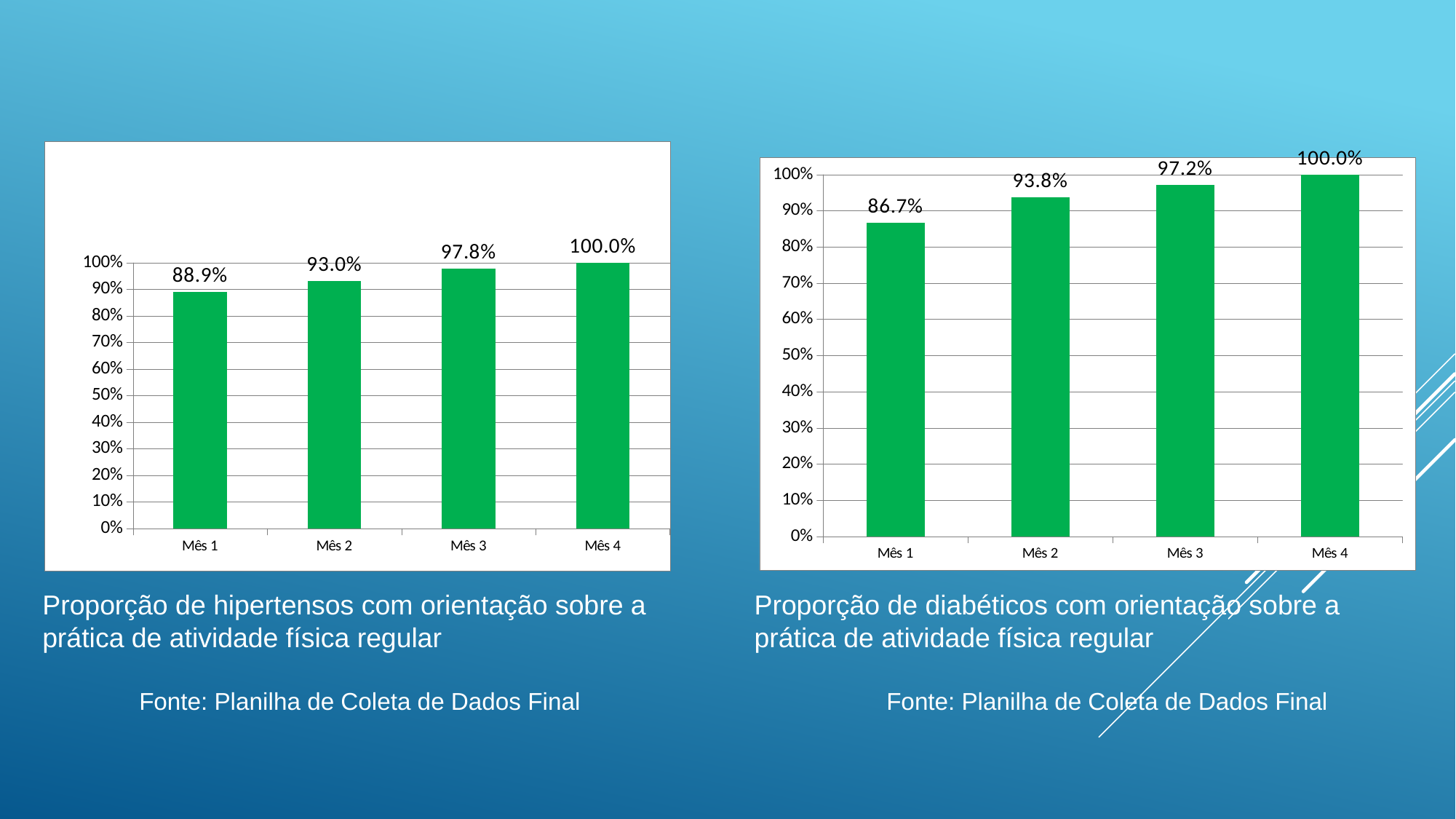
What type of chart is the left chart (hipertensos)? Bar chart In the right chart (diabéticos), what is the value for Mês 1? 86.7% In the left chart (hipertensos), what is the value for Mês 3? 97.8% In the left chart (hipertensos), what is the difference between the values for Mês 4 and Mês 1? 11.1% Which is larger: the Mês 1 value in the left chart (hipertensos) or the Mês 1 value in the right chart (diabéticos)? Left chart (hipertensos), 88.9% In the right chart (diabéticos), which month has the highest value? Mês 4 In the right chart (diabéticos), what is the difference between the values for Mês 3 and Mês 2? 3.4% In the left chart (hipertensos), what is the value for Mês 1? 88.9% In the right chart (diabéticos), what is the value for Mês 2? 93.8% How many months are shown on the x axis of the right chart (diabéticos)? 4 In the right chart (diabéticos), do the values rise or fall from Mês 1 to Mês 4? Rise In the left chart (hipertensos), which month has the lowest value? Mês 1